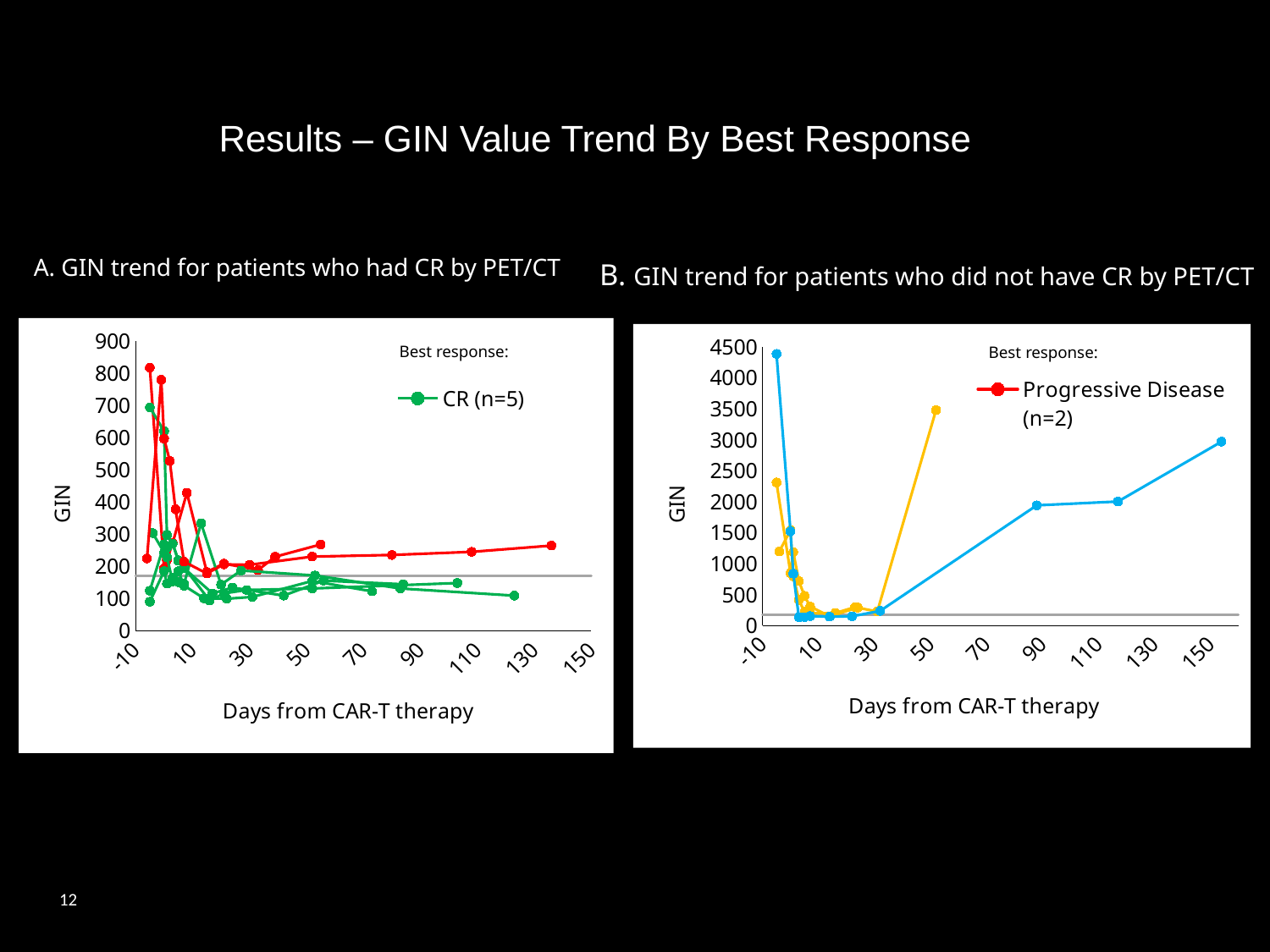
In chart A (GIN trend for patients who had CR by PET/CT), what is the x-axis title? Days from CAR-T therapy In chart B (GIN trend for patients who did not have CR by PET/CT), is the last point on the blue line (around day 155) greater or less than 2500? greater In chart A (GIN trend for patients who had CR by PET/CT), is the highest point on the red line greater or less than 700? greater In chart B (GIN trend for patients who did not have CR by PET/CT), what is the legend entry under 'Best response:'? Progressive Disease (n=2) How many series does the legend list in chart A (GIN trend for patients who had CR by PET/CT)? 1 In chart A (GIN trend for patients who had CR by PET/CT), is the last red point (around day 140) greater or less than 200? greater How many series does the legend list in chart B (GIN trend for patients who did not have CR by PET/CT)? 1 What kind of chart is chart A (GIN trend for patients who had CR by PET/CT)? line chart In chart B (GIN trend for patients who did not have CR by PET/CT), does the blue line rise or fall between day 90 and day 150? rise